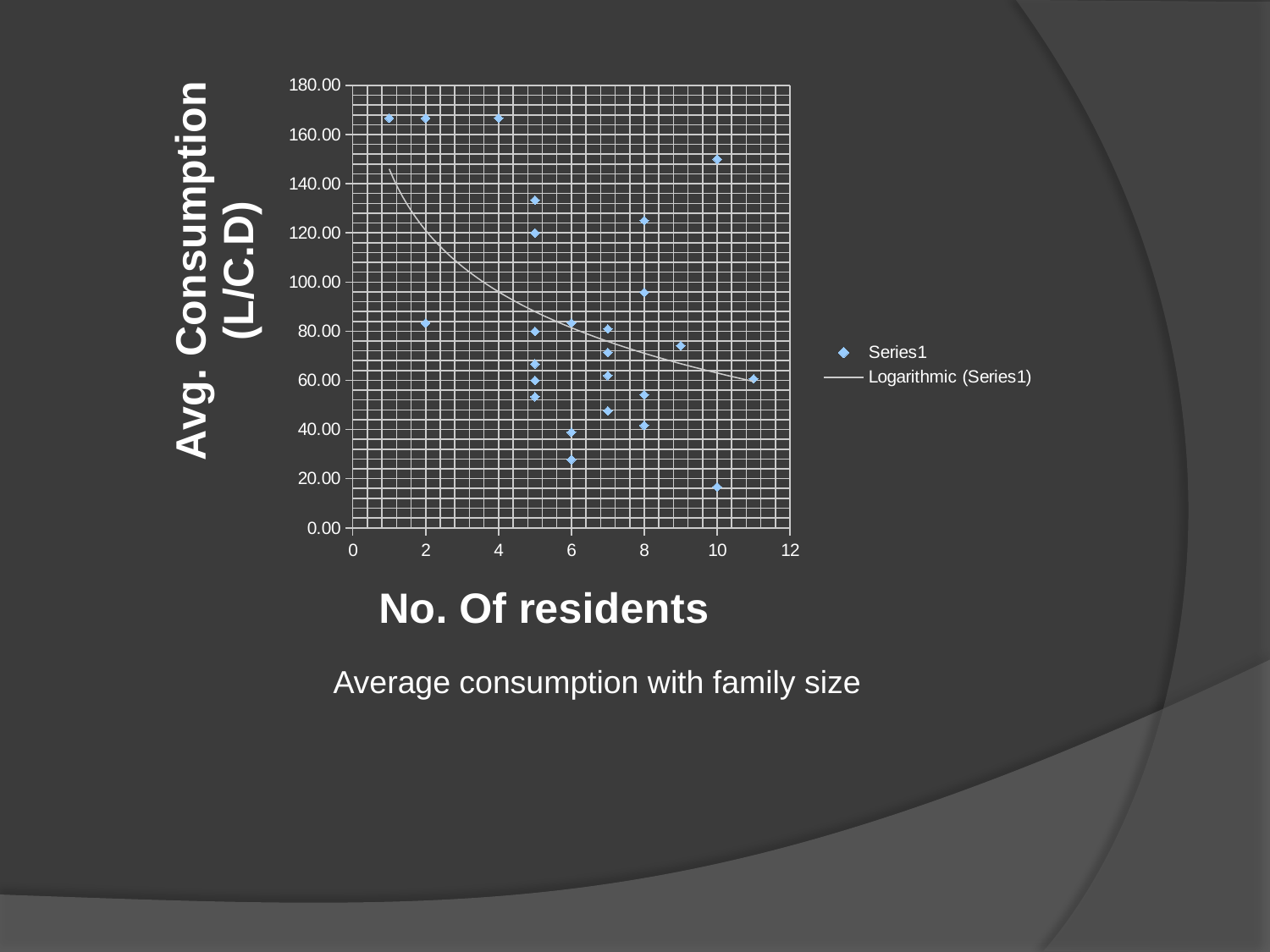
What kind of chart is shown on the slide? Scatter chart Is the value for the point at 1 resident greater or less than 160? greater How many entries does the chart legend list? 2 Is the value for the lowest point at 10 residents greater or less than 20? less Is the value for the point at 4 residents greater or less than 140? greater Does the logarithmic trendline rise or fall as the number of residents increases? Fall What is the title of the y axis of the chart? Avg. Consumption (L/C.D) What is the title of the x axis of the chart? No. Of residents At which number of residents is the lowest plotted value found? 10